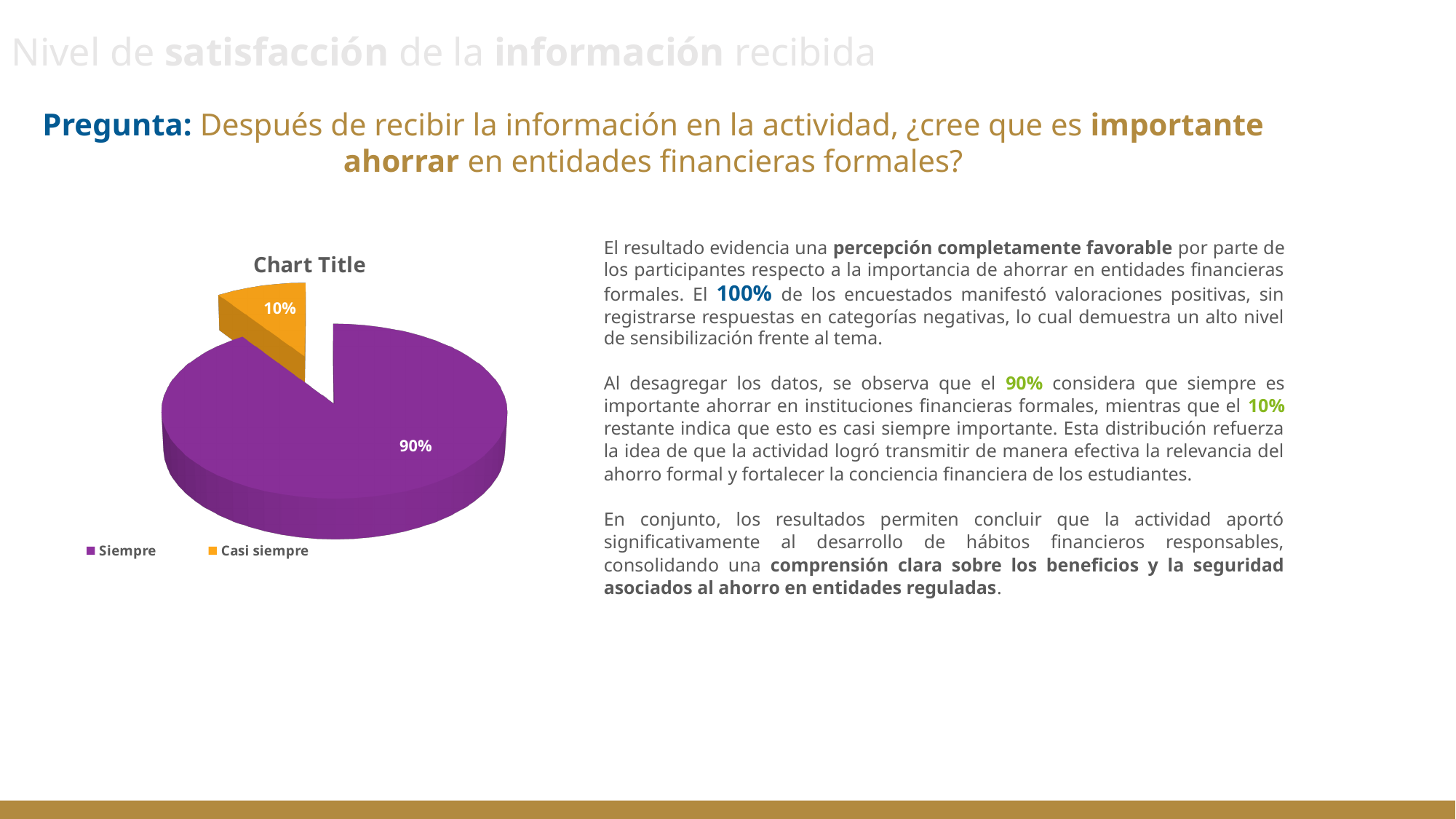
What share of the pie does the Casi siempre slice represent? 10% What kind of chart is shown on the slide? Pie chart What is the value for Siempre? 90% What is the difference between the values for Siempre and Casi siempre? 80% What is the value for Casi siempre? 10% Which category has the smallest slice? Casi siempre Which is larger, the value for Siempre or the value for Casi siempre? Siempre What is the title shown above the pie chart? Chart Title What colour is the Siempre slice? Purple How many entries does the legend list? 2 How many categories does the pie chart show? 2 Which category has the largest slice? Siempre